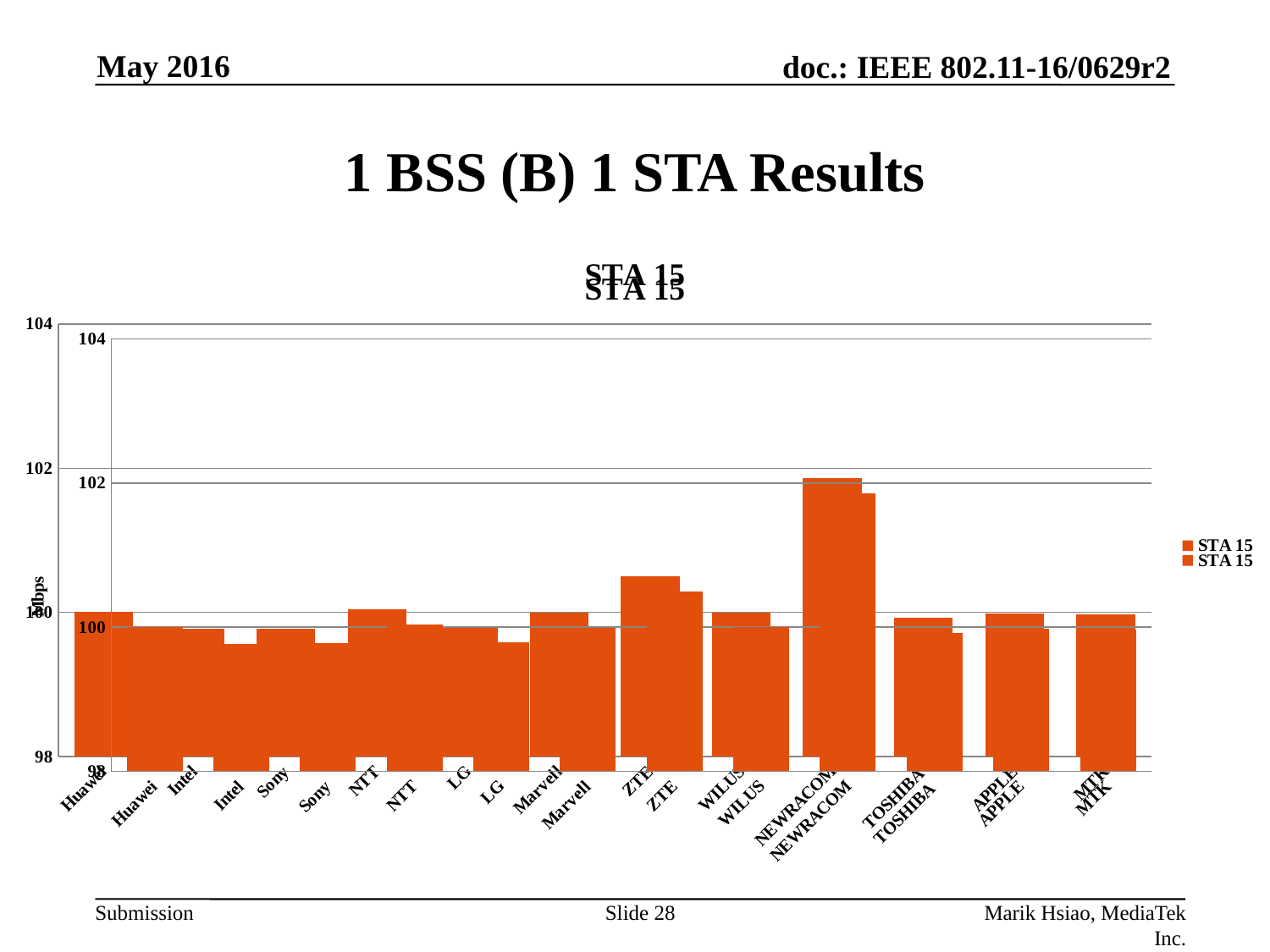
How many categories are shown on the x axis of the STA 15 chart? 12 In the STA 15 chart, is the value for ZTE greater or less than 100? greater In the STA 15 chart, is the value for Intel greater or less than 100? less In the STA 15 chart, is the value for NEWRACOM greater or less than 100? greater What is the label on the y axis of the STA 15 chart? Mbps What kind of chart is the STA 15 chart? bar chart Which category has the highest value in the STA 15 chart? NEWRACOM What is the title of the chart on the slide? STA 15 How many series does the legend of the STA 15 chart list? 1 In the STA 15 chart, which is larger, the value for NEWRACOM or the value for ZTE? NEWRACOM